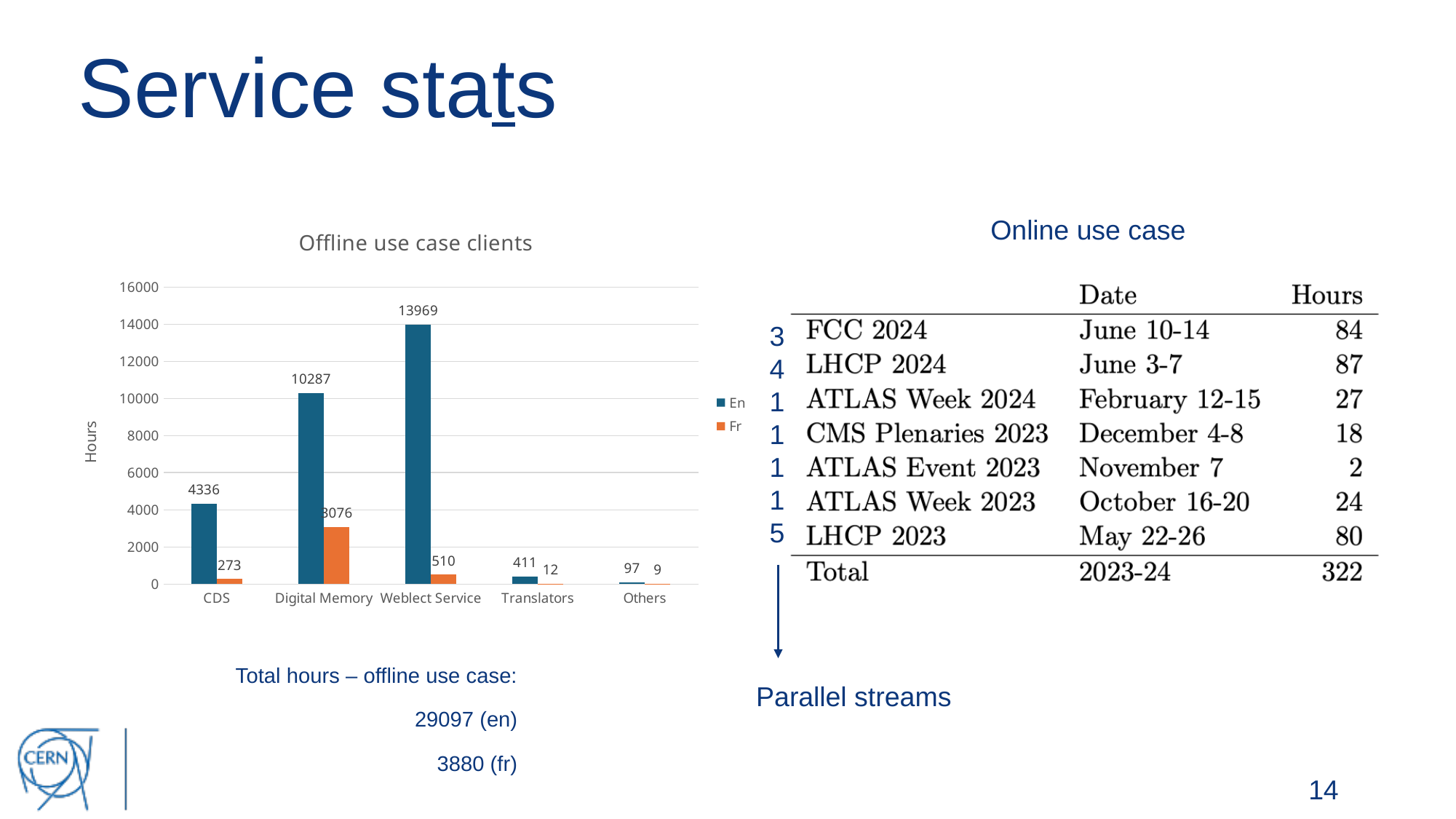
Which is larger, the Fr value for CDS or the Fr value for Weblect Service? Weblect Service What is the difference between the En values for Weblect Service and Digital Memory? 3682 What is the En value for Weblect Service? 13969 What is the Fr value for Digital Memory? 3076 What is the label of the y axis of the chart? Hours How many series does the legend of the chart list? 2 What type of chart is used for the offline use case clients? Bar chart What is the En value for CDS? 4336 How many client categories are shown on the x axis of the chart? 5 Which category has the highest En value? Weblect Service What is the title of the chart on the slide? Offline use case clients Which category has the lowest Fr value? Others